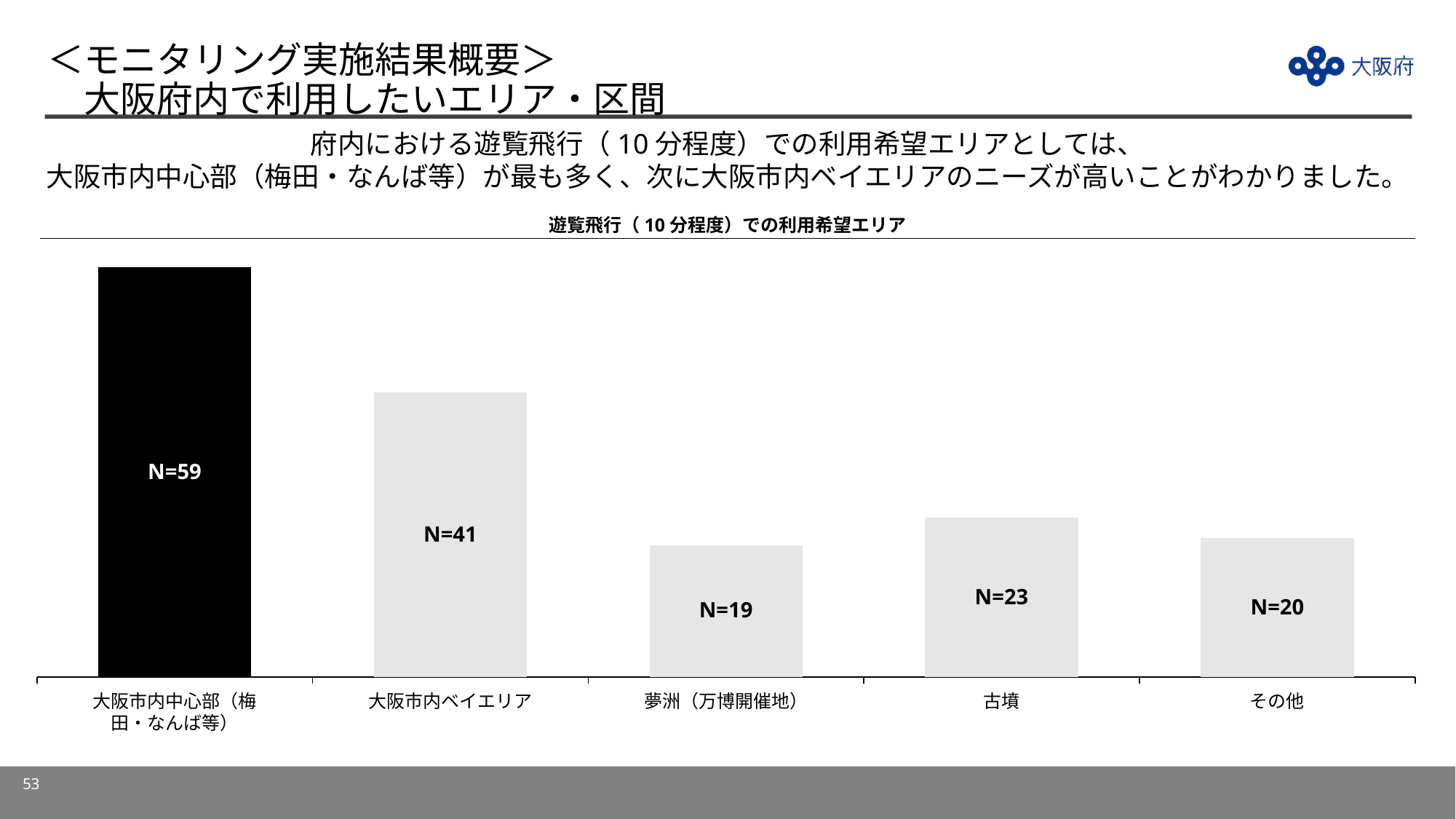
What kind of chart is shown on the slide? Bar chart Which category has the highest value? 大阪市内中心部（梅田・なんば等） What is the value for 大阪市内ベイエリア? N=41 Which is larger, the value for 古墳 or the value for その他? 古墳 What is the value for その他? N=20 What is the title of the chart? 遊覧飛行（10分程度）での利用希望エリア What is the difference between the values for 大阪市内中心部（梅田・なんば等） and 大阪市内ベイエリア? 18 Which category has the lowest value? 夢洲（万博開催地） What is the value for 大阪市内中心部（梅田・なんば等）? N=59 What is the value for 古墳? N=23 What is the value for 夢洲（万博開催地）? N=19 How many categories are shown in the chart? 5